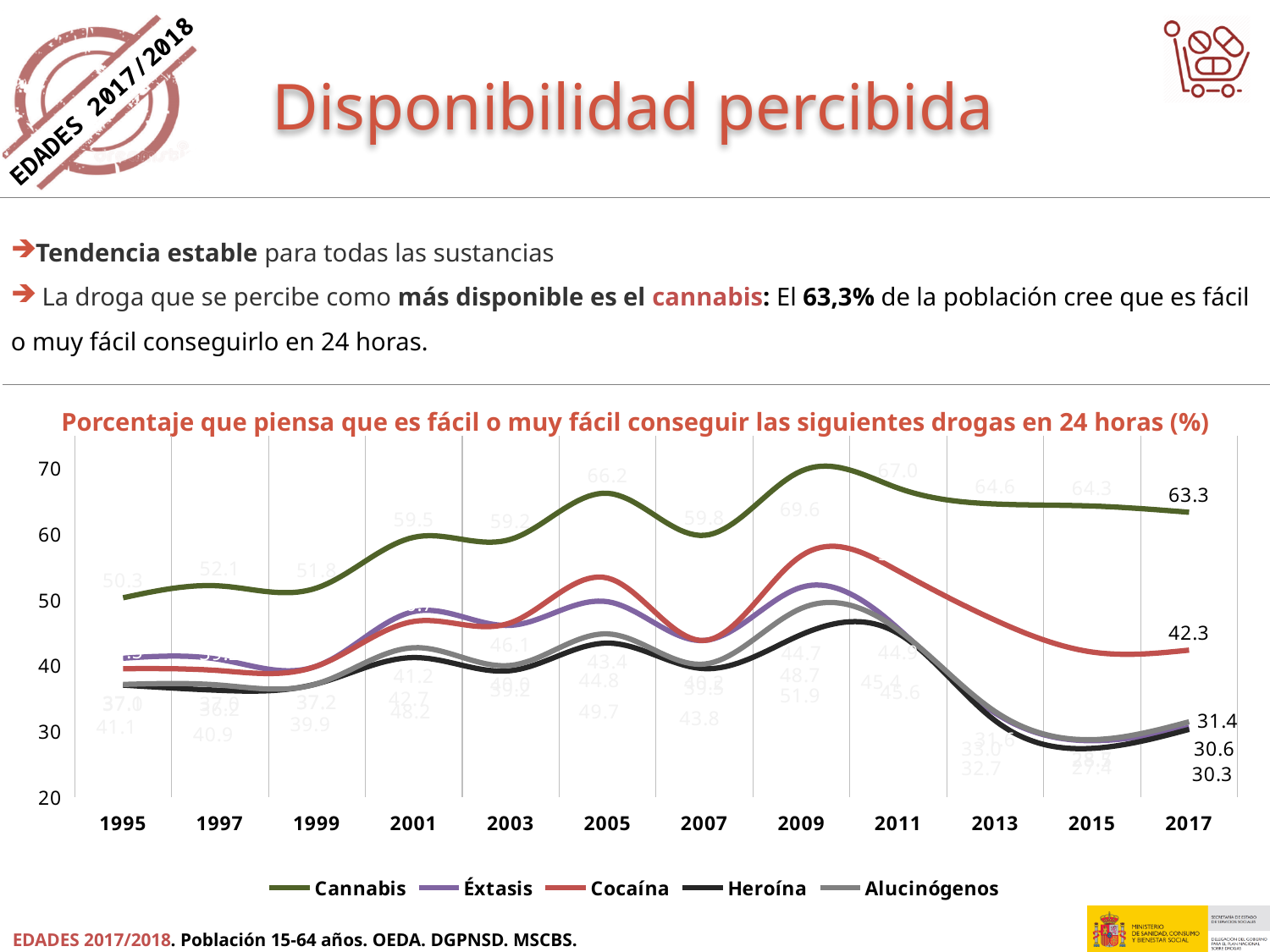
Does the Cannabis line rise or fall from 2011 to 2017? fall Which is larger in 2017, Cannabis or Cocaína? Cannabis How many years are shown on the x axis? 12 How many series does the legend list? 5 Is the value for Heroína in 2015 greater or less than 30? less What is the value for Cocaína in 2017? 42.3 What is the difference between Cannabis and Cocaína in 2017? 21.0 Is the value for Cocaína in 2009 greater or less than 50? greater Which substance has the highest value in 2017? Cannabis What type of chart is shown on the slide? line chart What is the title of the chart? Porcentaje que piensa que es fácil o muy fácil conseguir las siguientes drogas en 24 horas (%) What is the value for Cannabis in 2017? 63.3